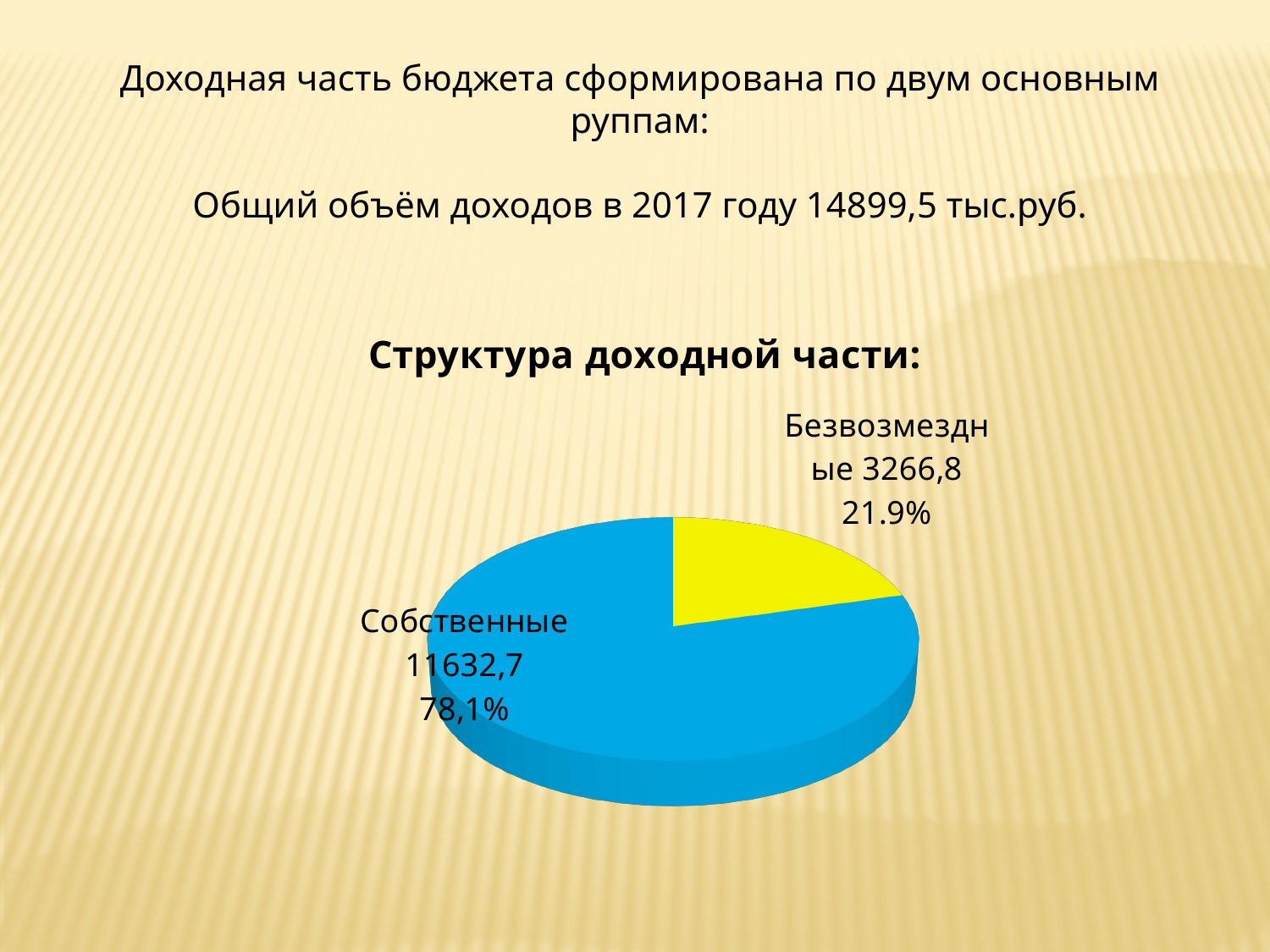
What share of the pie does the Безвозмездные slice represent? 21.9% Which slice of the pie chart is the smallest? Безвозмездные What is the title of the chart? Структура доходной части: What is the difference between the values for Собственные and Безвозмездные? 8365,9 What share of the pie does the Собственные slice represent? 78,1% What is the value shown for Собственные in the pie chart? 11632,7 Which is larger, Собственные or Безвозмездные? Собственные How many slices does the pie chart have? 2 What is the value shown for Безвозмездные in the pie chart? 3266,8 What is the total of the two slices in the pie chart? 14899,5 What type of chart is shown on the slide? Pie chart Which slice of the pie chart is the largest? Собственные